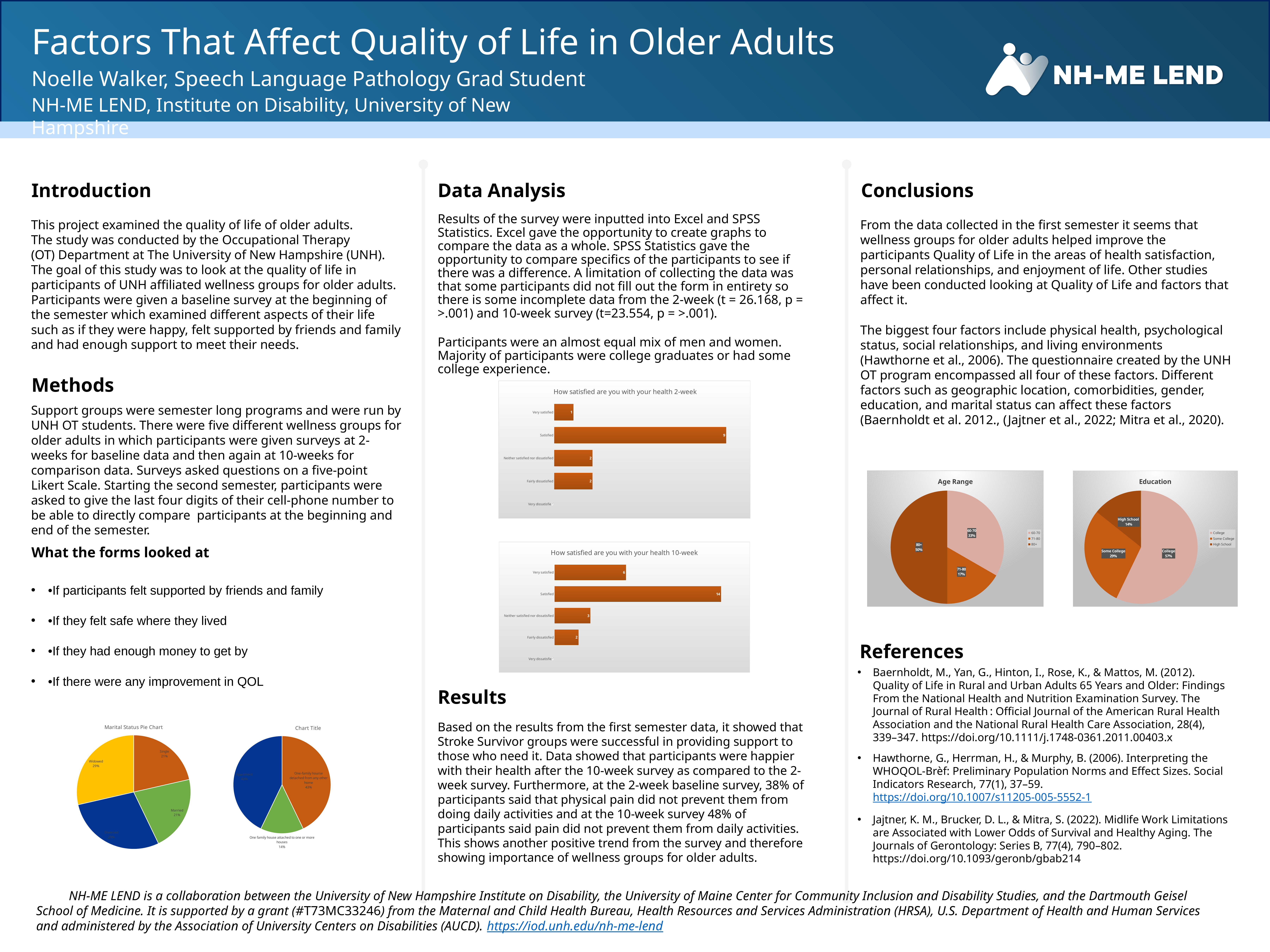
In the 'Education' pie chart, what share is College? 57% In the 'How satisfied are you with your health 10-week' chart, what is the value for Satisfied? 14 In the 'How satisfied are you with your health 10-week' chart, what is the value for Very satisfied? 6 In the 'How satisfied are you with your health 10-week' chart, which category has the highest value? Satisfied In the 'Education' pie chart, which is larger, Some College or High School? Some College In the 'Age Range' pie chart, what share is 80+? 50% In the 'Age Range' pie chart, which age group has the smallest share? 71-80 In the 'How satisfied are you with your health 2-week' chart, what is the value for Satisfied? 9 In the 'How satisfied are you with your health 2-week' chart, what is the value for Very satisfied? 1 What is the difference between the Satisfied values in the 10-week chart and the 2-week chart? 5 How many entries does the legend of the 'Education' pie chart list? 3 What type of chart is 'How satisfied are you with your health 2-week'? Bar chart